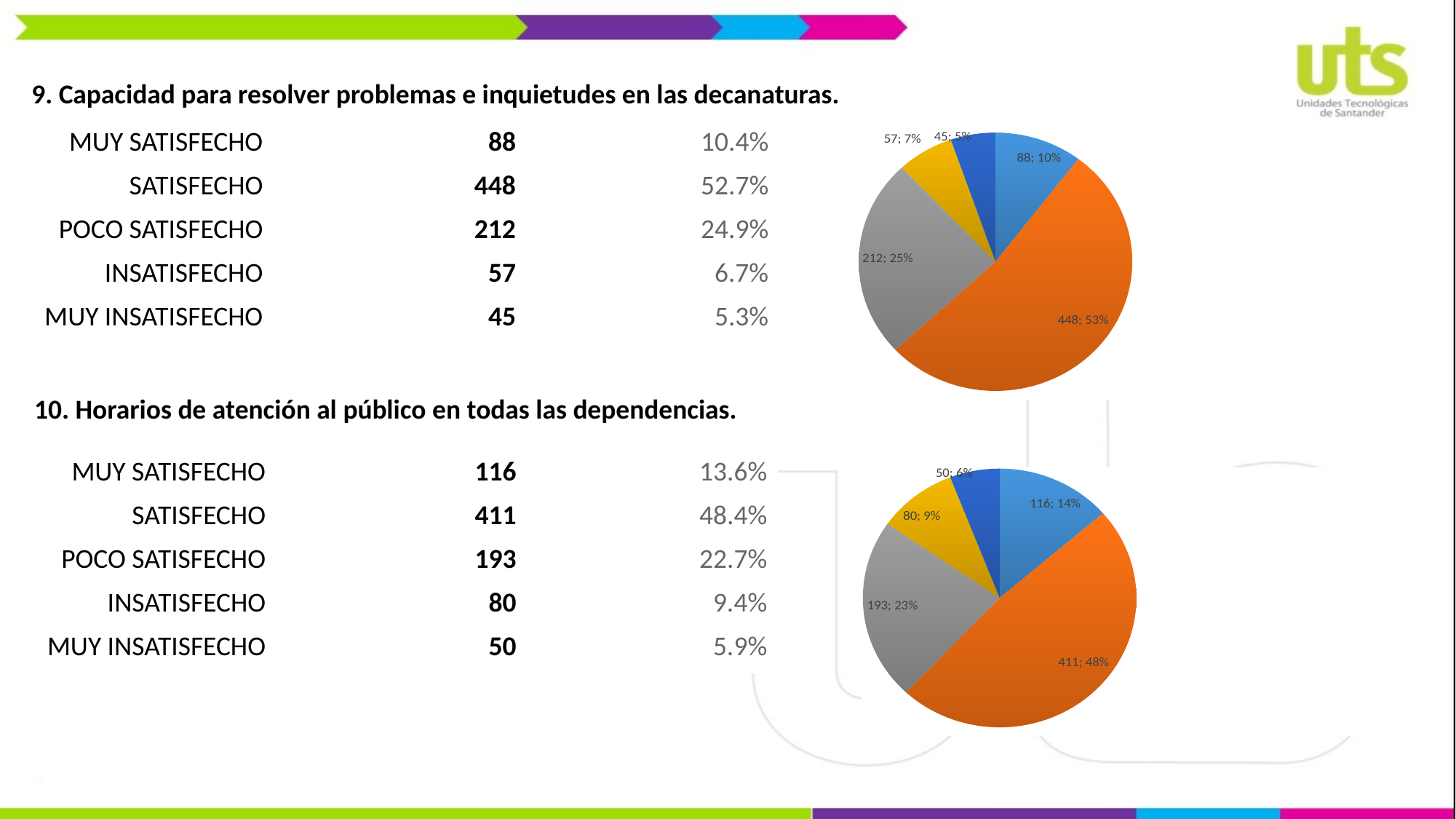
In the top pie chart (question 9), what value is shown on the largest slice? 448; 53% How many slices does the bottom pie chart (question 10) have? 5 What kind of chart is shown next to question 9 (top chart)? pie chart In the top pie chart (question 9), what share of the pie does the slice labelled 212 represent? 25% How many slices does the top pie chart (question 9) have? 5 In the top pie chart (question 9), what colour is the largest slice? orange In the top pie chart (question 9), what is the difference between the slice labelled 448 and the slice labelled 212? 236 In the bottom pie chart (question 10), what value is shown on the largest slice? 411; 48% In the top pie chart (question 9), which slice is the smallest? 45; 5% In the bottom pie chart (question 10), which is larger: the slice labelled 80 or the slice labelled 50? 80 In the bottom pie chart (question 10), what is the difference between the slice labelled 193 and the slice labelled 80? 113 In the bottom pie chart (question 10), what share of the pie does the slice labelled 116 represent? 14%